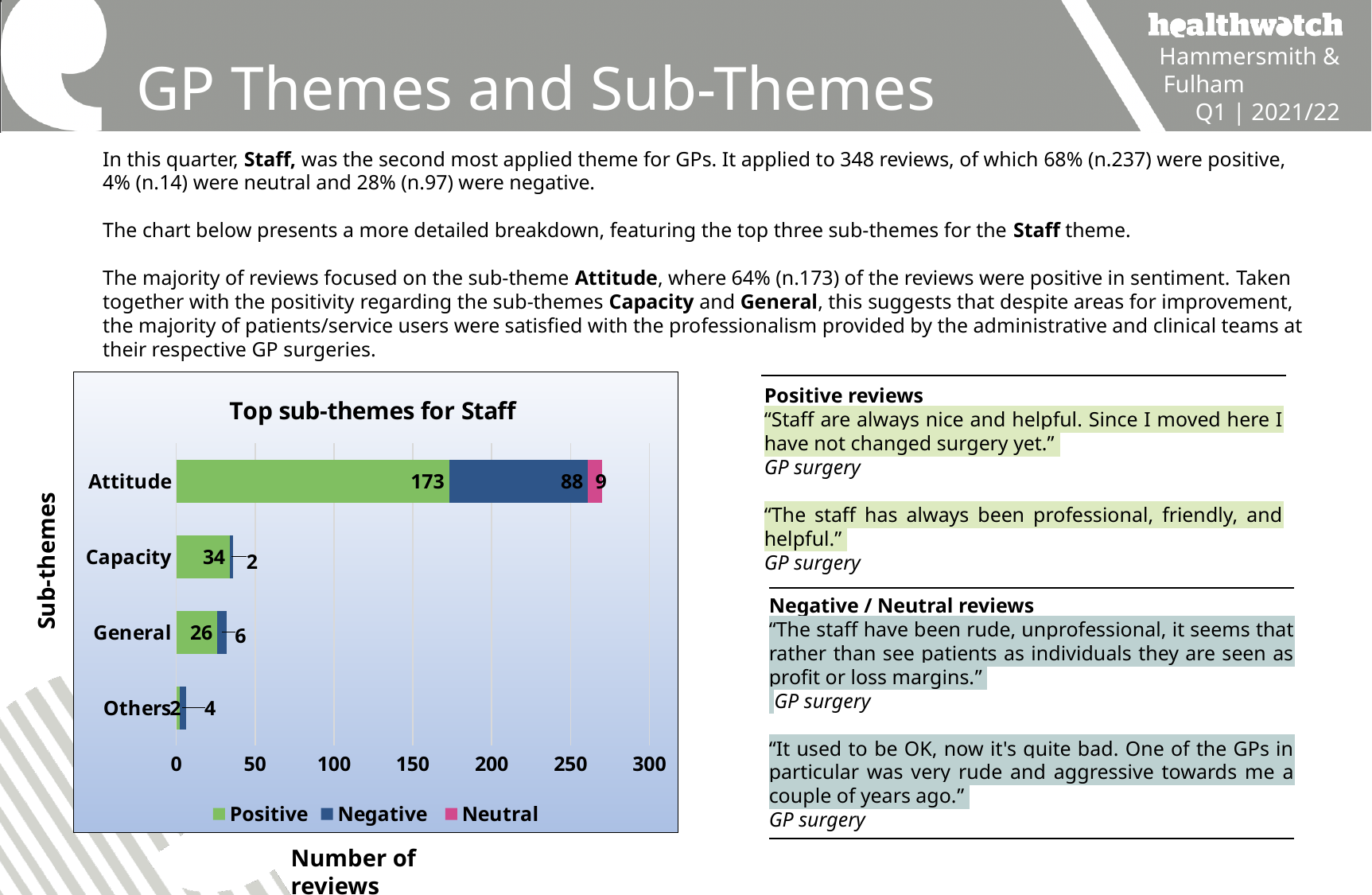
How many series does the chart legend list? 3 How many sub-theme categories are shown on the chart? 4 What is the Negative value for General? 6 What is the Negative value for Attitude? 88 What is the Positive value for Capacity? 34 What type of chart is shown on the slide? Bar chart What is the title of the chart? Top sub-themes for Staff What is the Neutral value for Attitude? 9 What is the Positive value for Attitude? 173 What is the difference between the Positive and Negative values for Attitude? 85 Is the Positive value for Capacity greater or less than 50? less Which sub-theme has the highest Positive value? Attitude